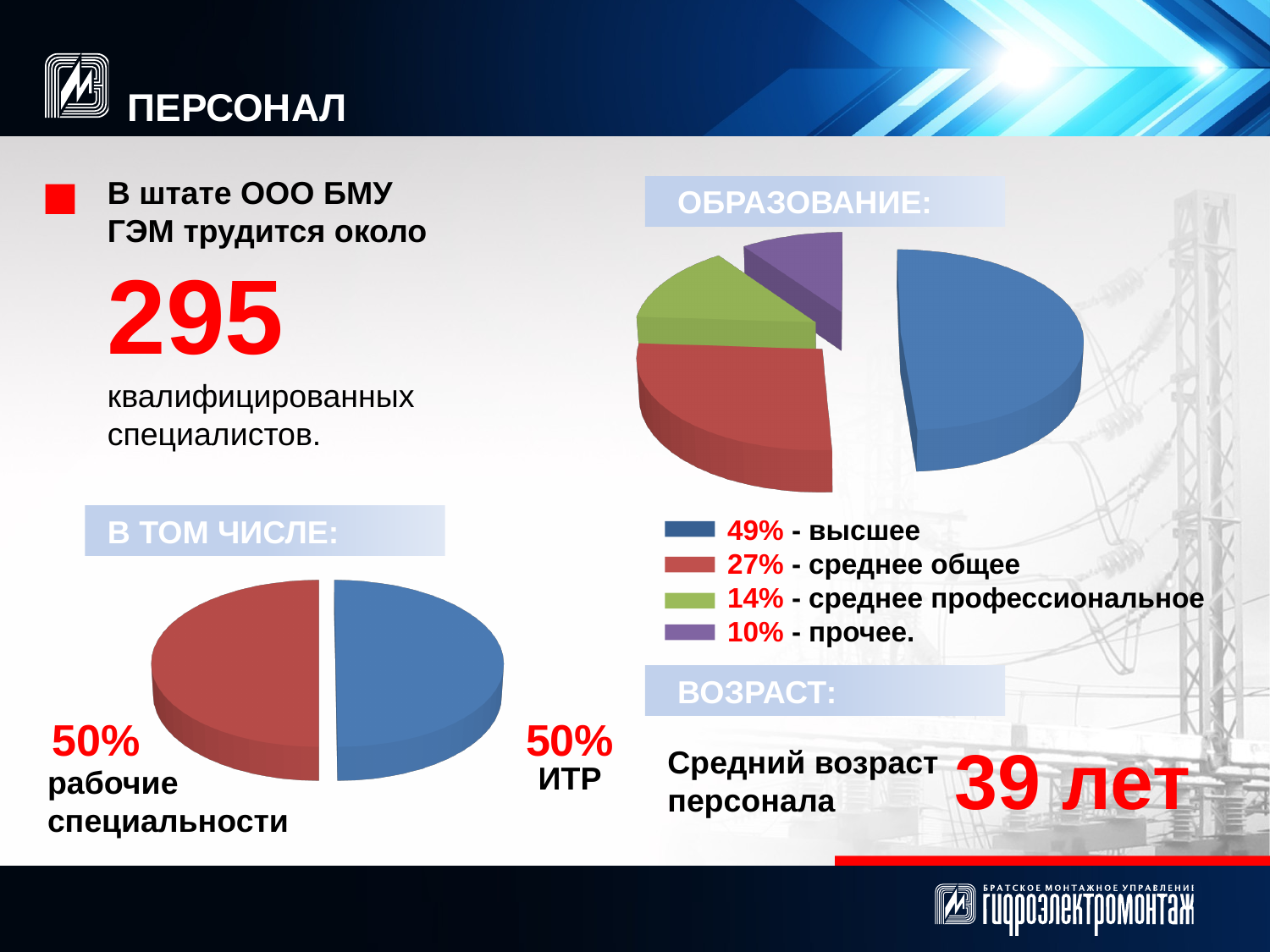
In the ОБРАЗОВАНИЕ pie chart, which is larger: среднее профессиональное or прочее? среднее профессиональное In the ОБРАЗОВАНИЕ pie chart, what share is среднее профессиональное? 14% In the ОБРАЗОВАНИЕ pie chart, which category has the smallest share? прочее In the ОБРАЗОВАНИЕ pie chart, what share of staff has высшее education? 49% What type of chart is used under the heading В ТОМ ЧИСЛЕ? pie chart In the ОБРАЗОВАНИЕ pie chart, what share is прочее? 10% In the ОБРАЗОВАНИЕ pie chart, what share is среднее общее? 27% How many categories does the ОБРАЗОВАНИЕ pie chart show? 4 In the ОБРАЗОВАНИЕ pie chart, which category has the largest share? высшее In the В ТОМ ЧИСЛЕ pie chart, what share is ИТР? 50% In the ОБРАЗОВАНИЕ pie chart, what is the difference between the высшее and среднее общее shares? 22% In the ОБРАЗОВАНИЕ pie chart, what colour represents высшее? blue